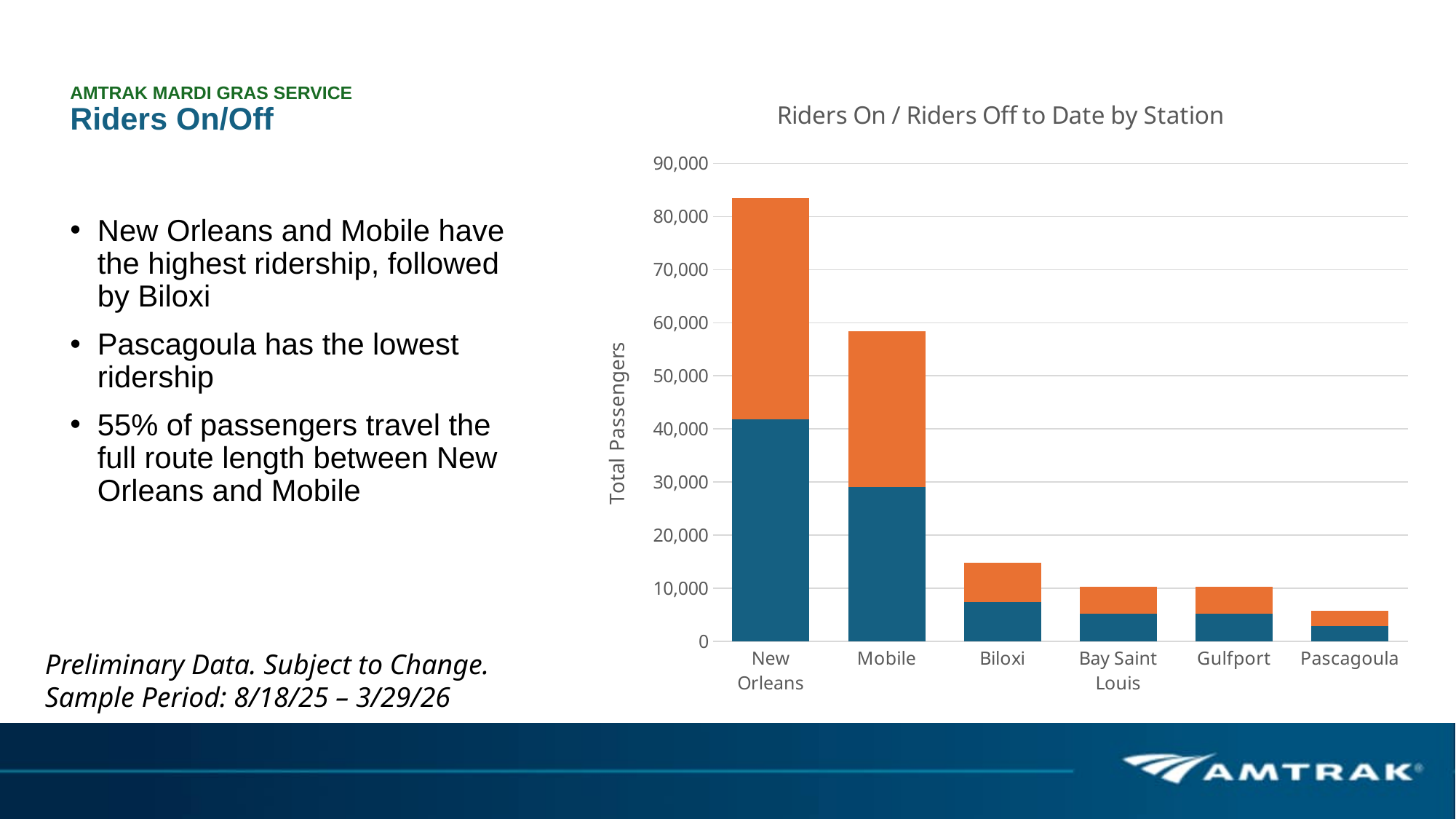
What is the title of the chart? Riders On / Riders Off to Date by Station Which station has more total passengers, Biloxi or Pascagoula? Biloxi Which station has the highest total passengers in the chart? New Orleans How many stations are shown on the x axis of the chart? 6 Is the total passengers value for New Orleans greater or less than 80,000? greater Which station has more total passengers, Mobile or Biloxi? Mobile Is the total passengers value for Pascagoula greater or less than 10,000? less Do the total passenger values generally rise or fall moving from left to right across the stations? fall Is the total passengers value for Mobile greater or less than 60,000? less What is the label on the vertical axis of the chart? Total Passengers What kind of chart is shown on the slide? Bar chart Which station has the lowest total passengers in the chart? Pascagoula